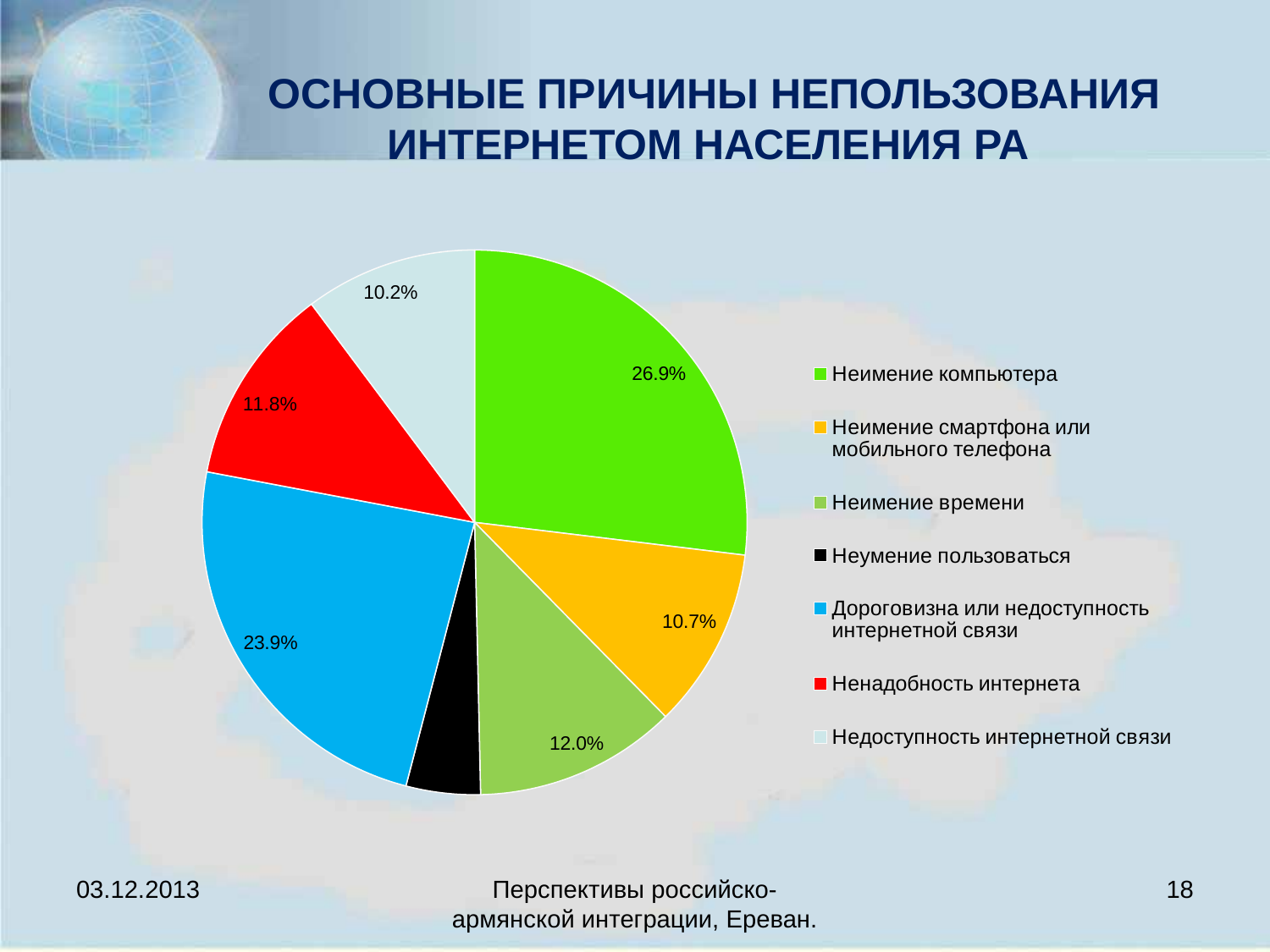
What colour represents "Ненадобность интернета" in the chart? Red What share of the pie does "Неимение компьютера" account for? 26.9% What is the title of the slide? ОСНОВНЫЕ ПРИЧИНЫ НЕПОЛЬЗОВАНИЯ ИНТЕРНЕТОМ НАСЕЛЕНИЯ РА What is the value shown for "Дороговизна или недоступность интернетной связи"? 23.9% What percentage is labelled for "Неимение времени"? 12.0% What type of chart is shown on the slide? Pie chart How many categories does the pie chart show? 7 Which reason has the smallest slice of the pie? Неумение пользоваться What is the difference between the shares for "Неимение компьютера" and "Дороговизна или недоступность интернетной связи"? 3.0 percentage points Which reason has the largest slice of the pie? Неимение компьютера Which is larger: the share for "Ненадобность интернета" or for "Неимение смартфона или мобильного телефона"? Ненадобность интернета What is the value for "Недоступность интернетной связи"? 10.2%